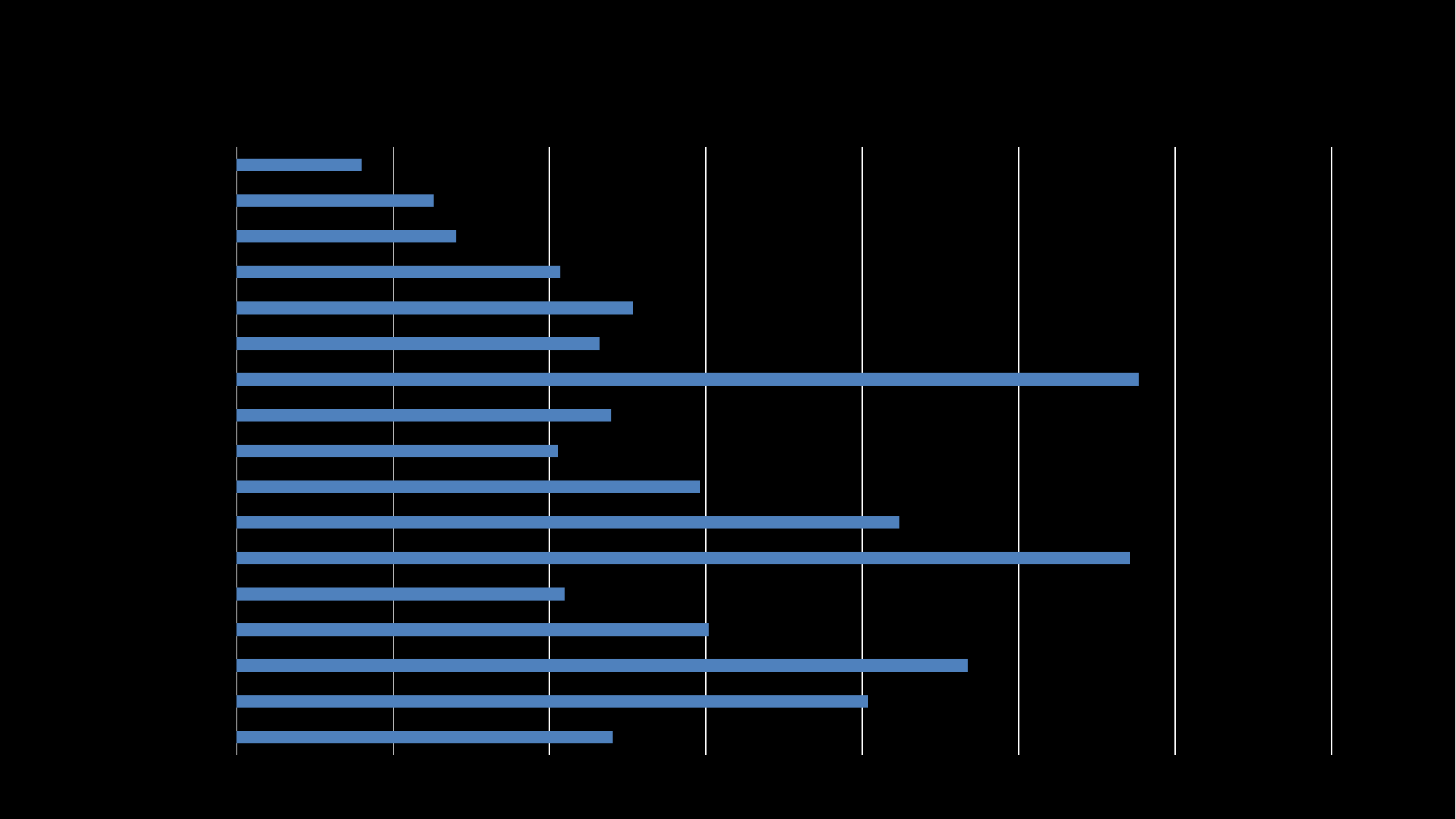
Counting from the top, which bar in the chart is the shortest? the first (top) bar Is the top bar in the chart longer or shorter than the bottom bar? shorter Are the bars in the chart drawn horizontally or vertically? horizontally What kind of chart is shown on the slide? bar chart How many bars are plotted in the chart? 17